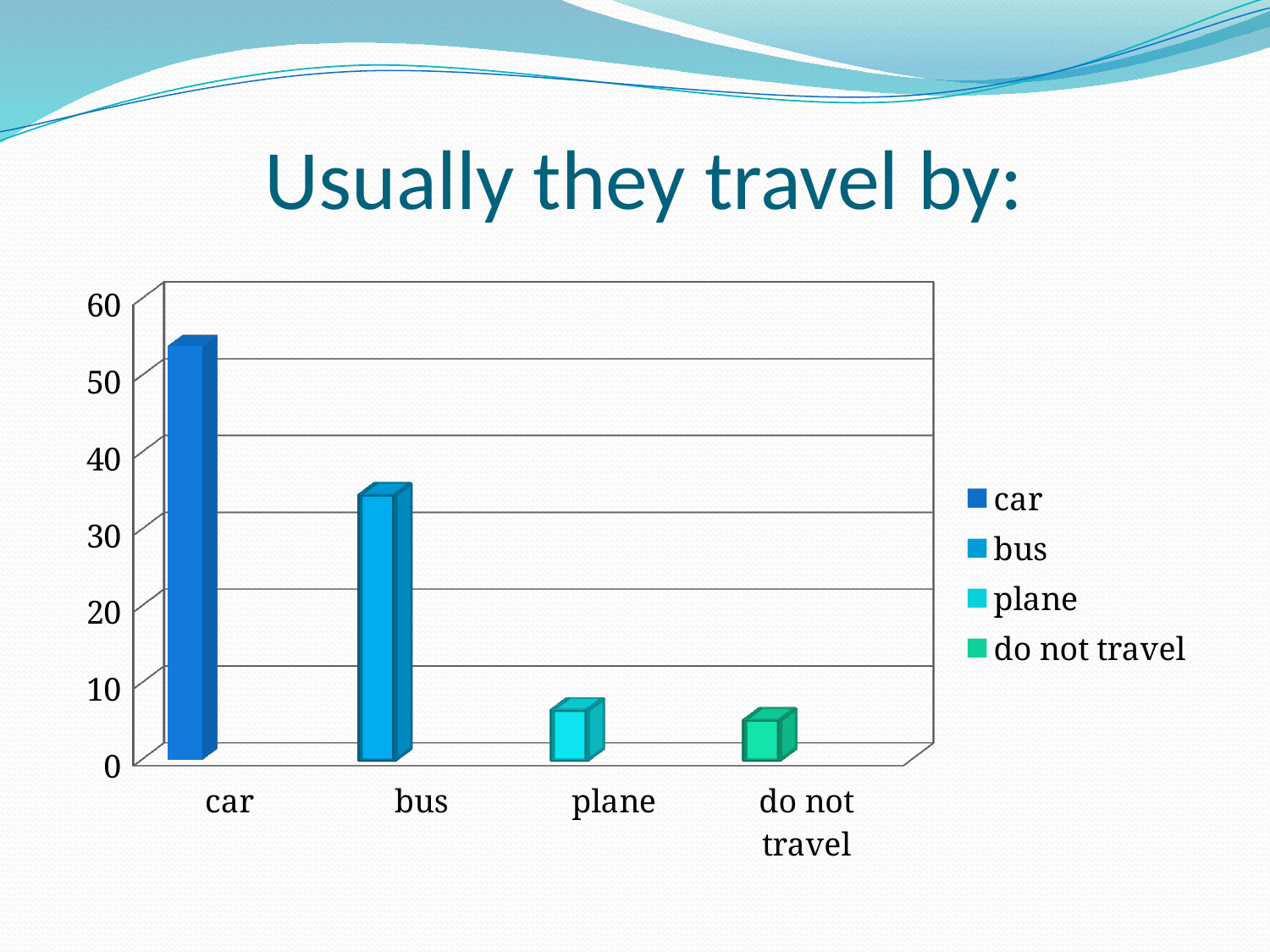
Is the value for car greater or less than 50? greater What is the title of the slide above the chart? Usually they travel by: How many entries does the chart's legend list? 4 Is the value for do not travel greater or less than 10? less What kind of chart is shown on the slide? bar chart Which is larger, the value for car or the value for bus? car Is the value for bus greater or less than 30? greater Which category has the highest bar in the chart? car How many categories are shown on the x axis of the chart? 4 Which is larger, the value for bus or the value for plane? bus